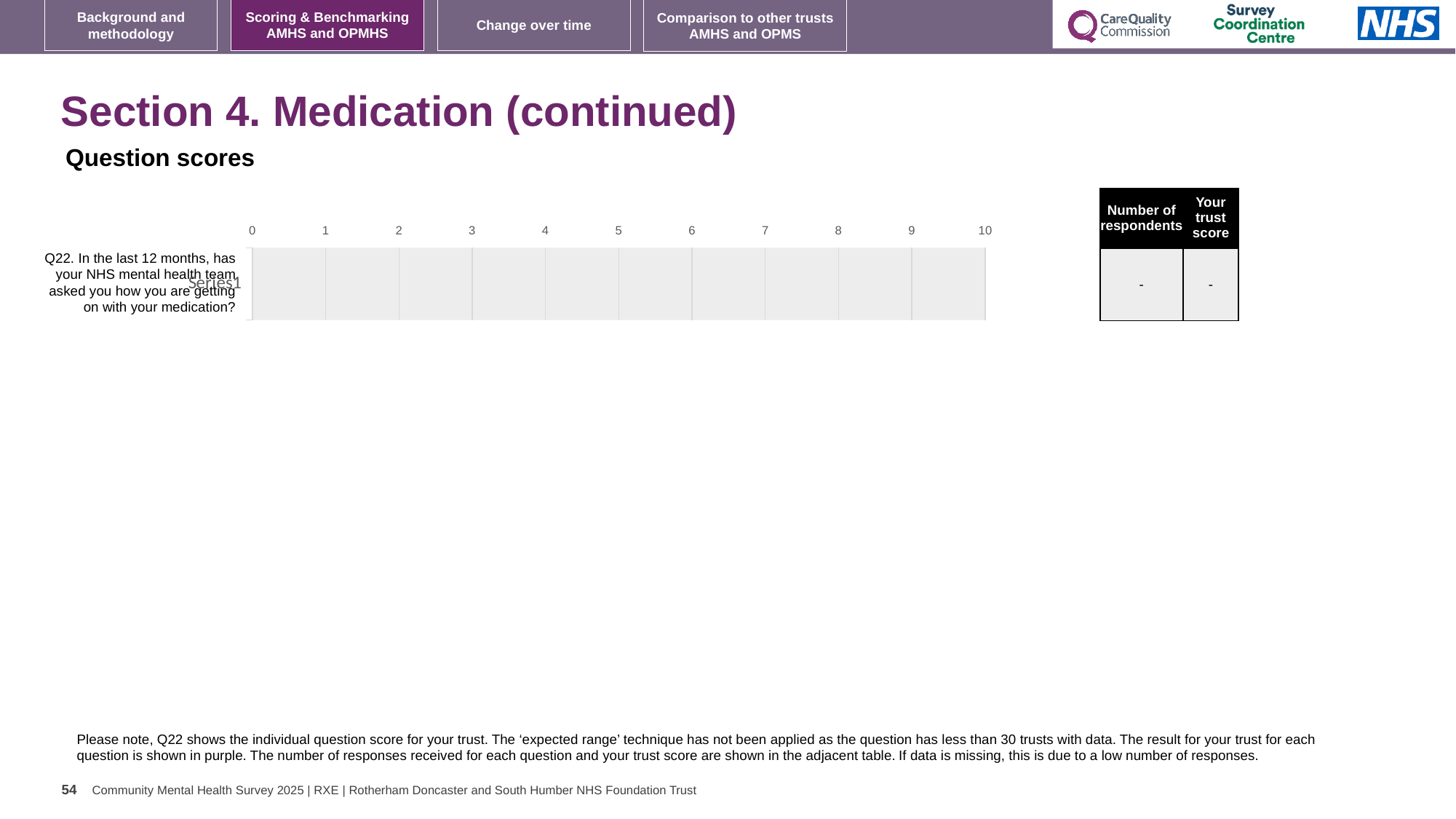
What value is shown in the 'Number of respondents' column of the table for Q22? - What kind of chart is shown under 'Question scores'? bar chart What is the highest value shown on the chart's horizontal axis? 10 How many questions (categories) are plotted on the chart? 1 Which question number is plotted on the chart? Q22 What value is shown in the 'Your trust score' column of the table for Q22? -